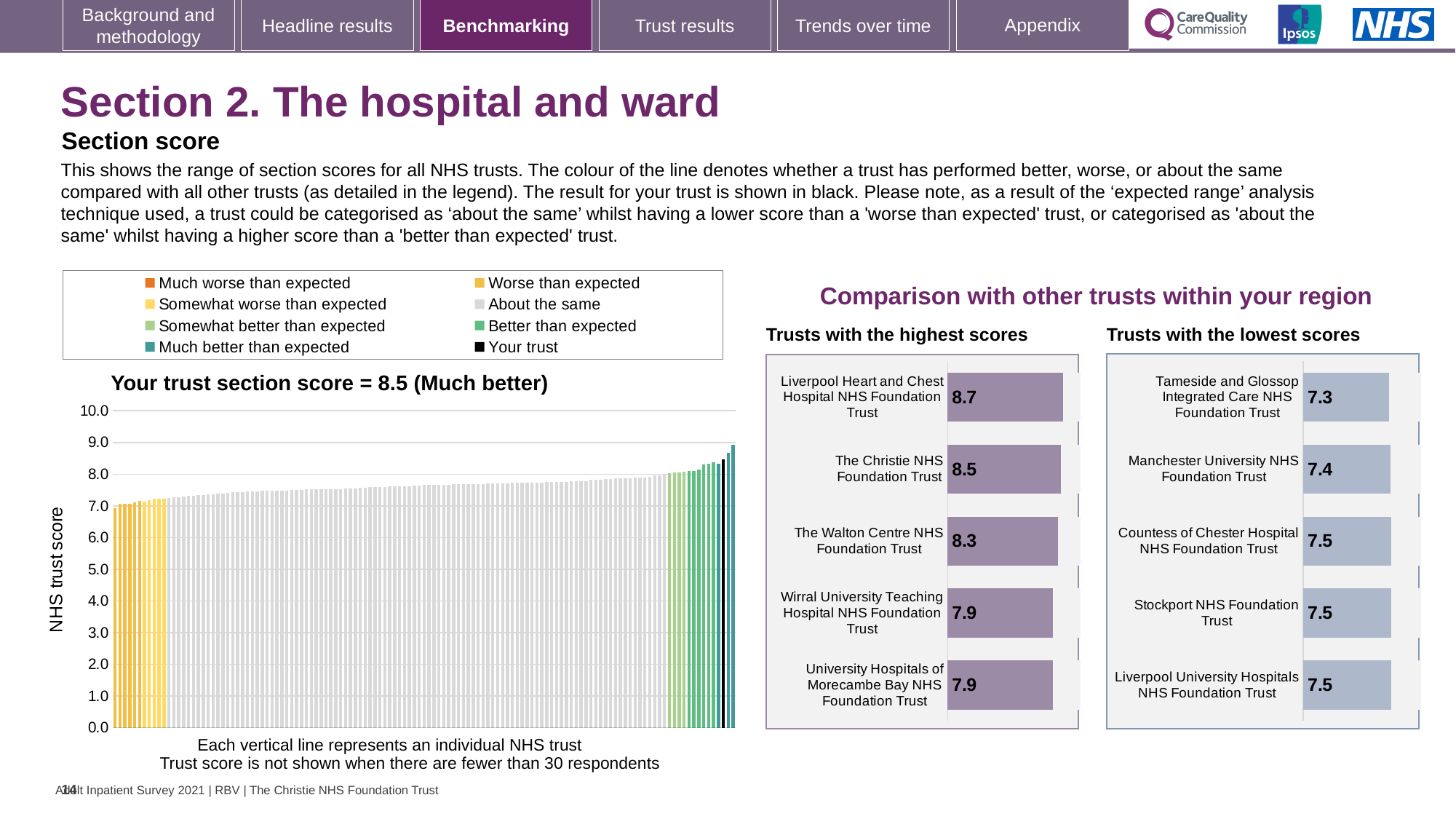
In the 'Trusts with the lowest scores' chart, what is the score for Manchester University NHS Foundation Trust? 7.4 In the 'Trusts with the highest scores' chart, how many trusts are listed? 5 In the 'Trusts with the highest scores' chart, what is the difference between the scores of Liverpool Heart and Chest Hospital NHS Foundation Trust and The Walton Centre NHS Foundation Trust? 0.4 In the 'Your trust section score' chart, what is the section score for your trust? 8.5 In the 'Trusts with the highest scores' chart, what is the score for The Christie NHS Foundation Trust? 8.5 How many entries does the legend above the 'Your trust section score' chart list? 8 In the 'Trusts with the lowest scores' chart, which has the larger score: Manchester University NHS Foundation Trust or Countess of Chester Hospital NHS Foundation Trust? Countess of Chester Hospital NHS Foundation Trust What kind of chart is the 'Your trust section score' chart? Bar chart In the 'Trusts with the highest scores' chart, what is the score for Wirral University Teaching Hospital NHS Foundation Trust? 7.9 In the 'Trusts with the lowest scores' chart, what is the difference between the scores of Stockport NHS Foundation Trust and Tameside and Glossop Integrated Care NHS Foundation Trust? 0.2 In the 'Trusts with the lowest scores' chart, which trust has the lowest score? Tameside and Glossop Integrated Care NHS Foundation Trust In the 'Trusts with the highest scores' chart, which trust has the highest score? Liverpool Heart and Chest Hospital NHS Foundation Trust